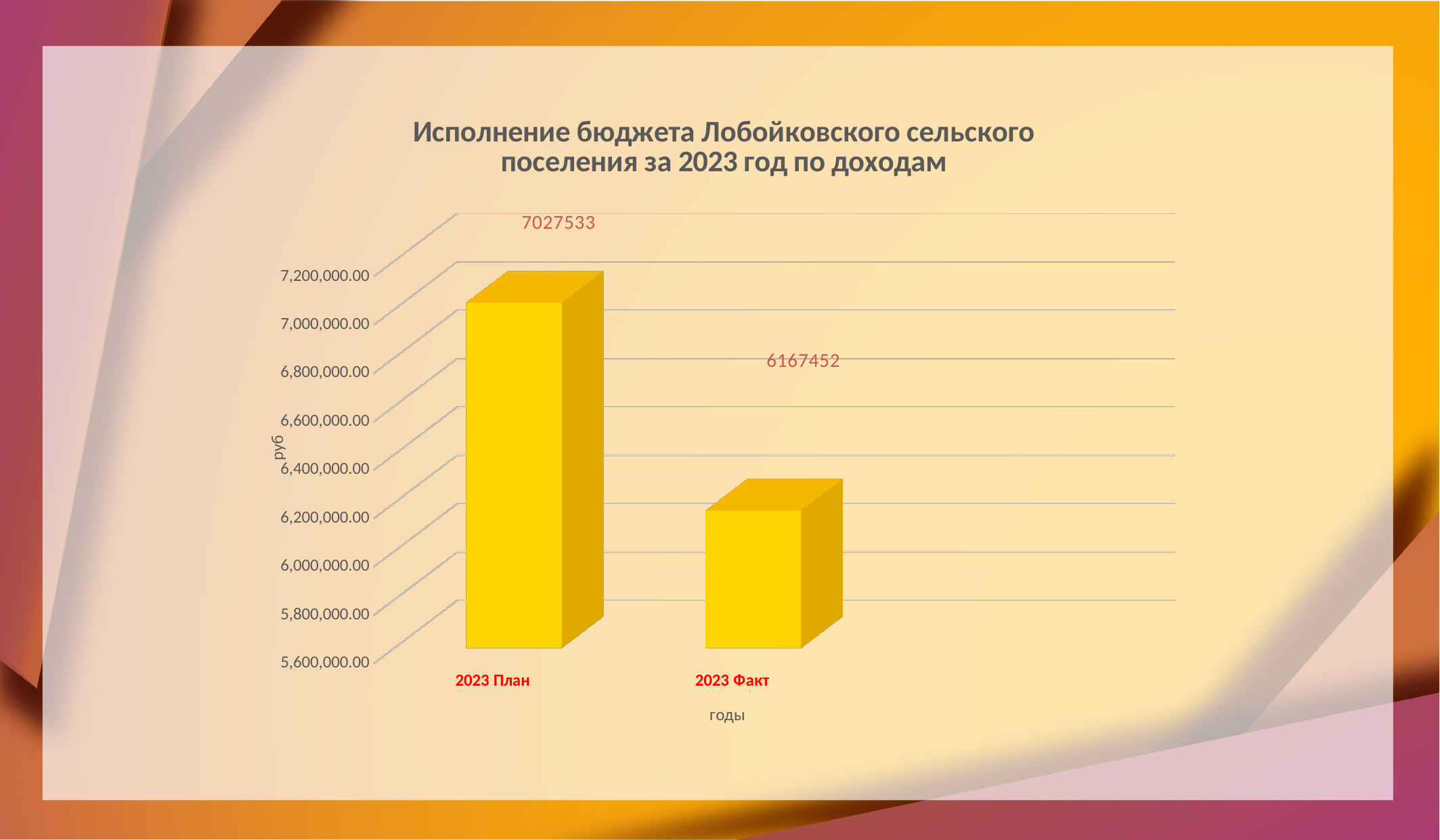
What is the title of the chart? Исполнение бюджета Лобойковского сельского поселения за 2023 год по доходам Which is larger, the value for 2023 План or the value for 2023 Факт? 2023 План What is the value for 2023 Факт? 6167452 Which category has the highest value? 2023 План What is the value for 2023 План? 7027533 Which category has the lowest value? 2023 Факт What kind of chart is shown on the slide? bar chart How many categories are shown on the x axis? 2 What is the difference between the values for 2023 План and 2023 Факт? 860081 Is the value for 2023 Факт greater or less than 6,400,000.00? less Is the value for 2023 План greater or less than 7,000,000.00? greater What is the label of the vertical axis? руб